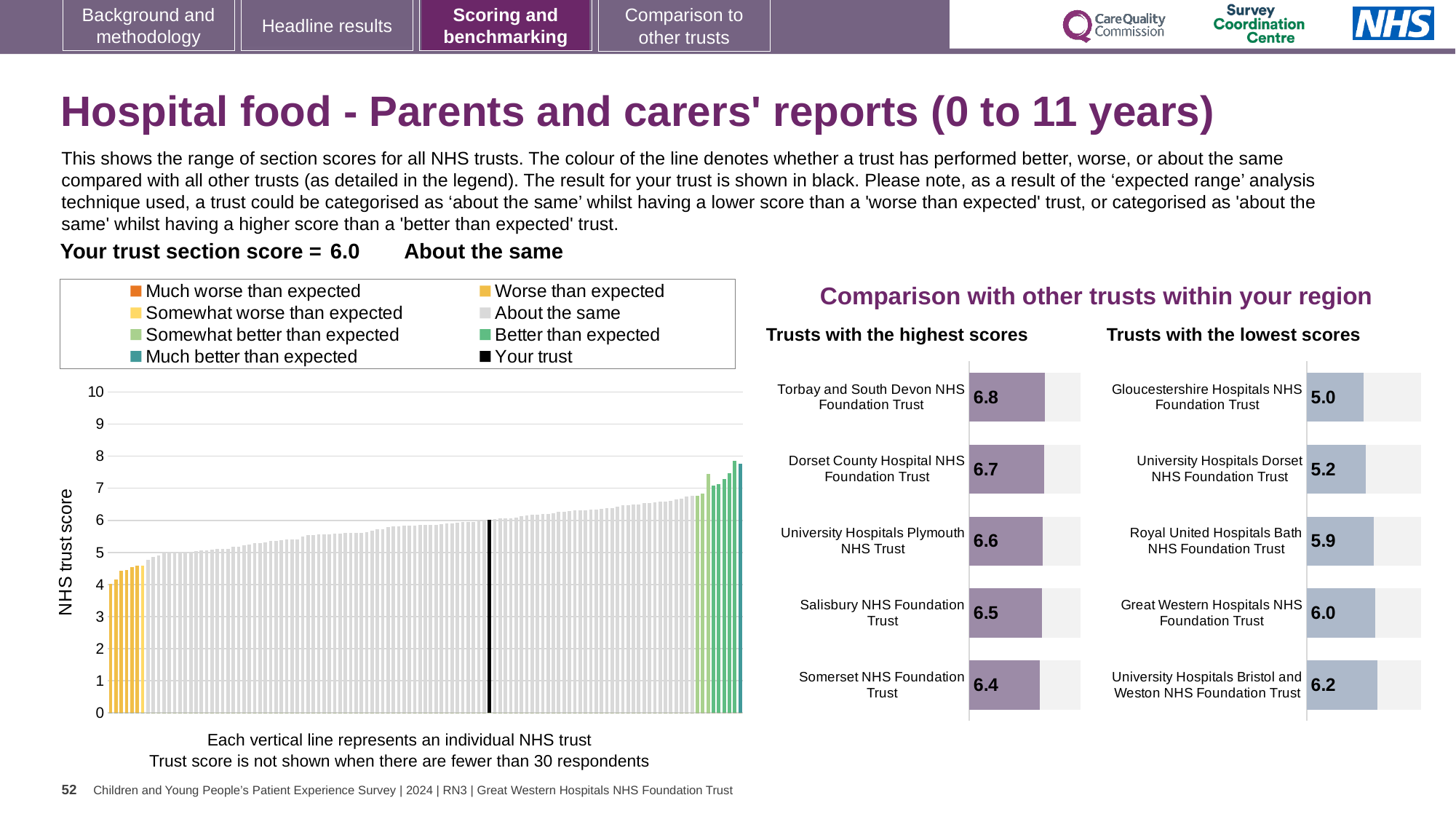
In the 'Trusts with the highest scores' chart, which trust has the lowest score shown? Somerset NHS Foundation Trust In the large chart on the left, do the trust scores rise or fall from left to right? Rise In the large chart on the left, is the value of the leftmost bar greater or less than 5? less In the 'Trusts with the highest scores' chart, what is the difference between the scores of Torbay and South Devon NHS Foundation Trust and Somerset NHS Foundation Trust? 0.4 In the 'Trusts with the lowest scores' chart, which has the higher score: Great Western Hospitals NHS Foundation Trust or University Hospitals Dorset NHS Foundation Trust? Great Western Hospitals NHS Foundation Trust How many trusts are shown in the 'Trusts with the highest scores' chart? 5 What kind of chart is the large chart on the left showing NHS trust scores? Bar chart In the 'Trusts with the lowest scores' chart, which trust has the highest score shown? University Hospitals Bristol and Weston NHS Foundation Trust In the 'Trusts with the lowest scores' chart, what is the difference between the scores of University Hospitals Bristol and Weston NHS Foundation Trust and Gloucestershire Hospitals NHS Foundation Trust? 1.2 In the 'Trusts with the lowest scores' chart, what is the score for Gloucestershire Hospitals NHS Foundation Trust? 5.0 In the 'Trusts with the highest scores' chart, what is the score for Torbay and South Devon NHS Foundation Trust? 6.8 How many entries does the legend above the large chart on the left list? 8